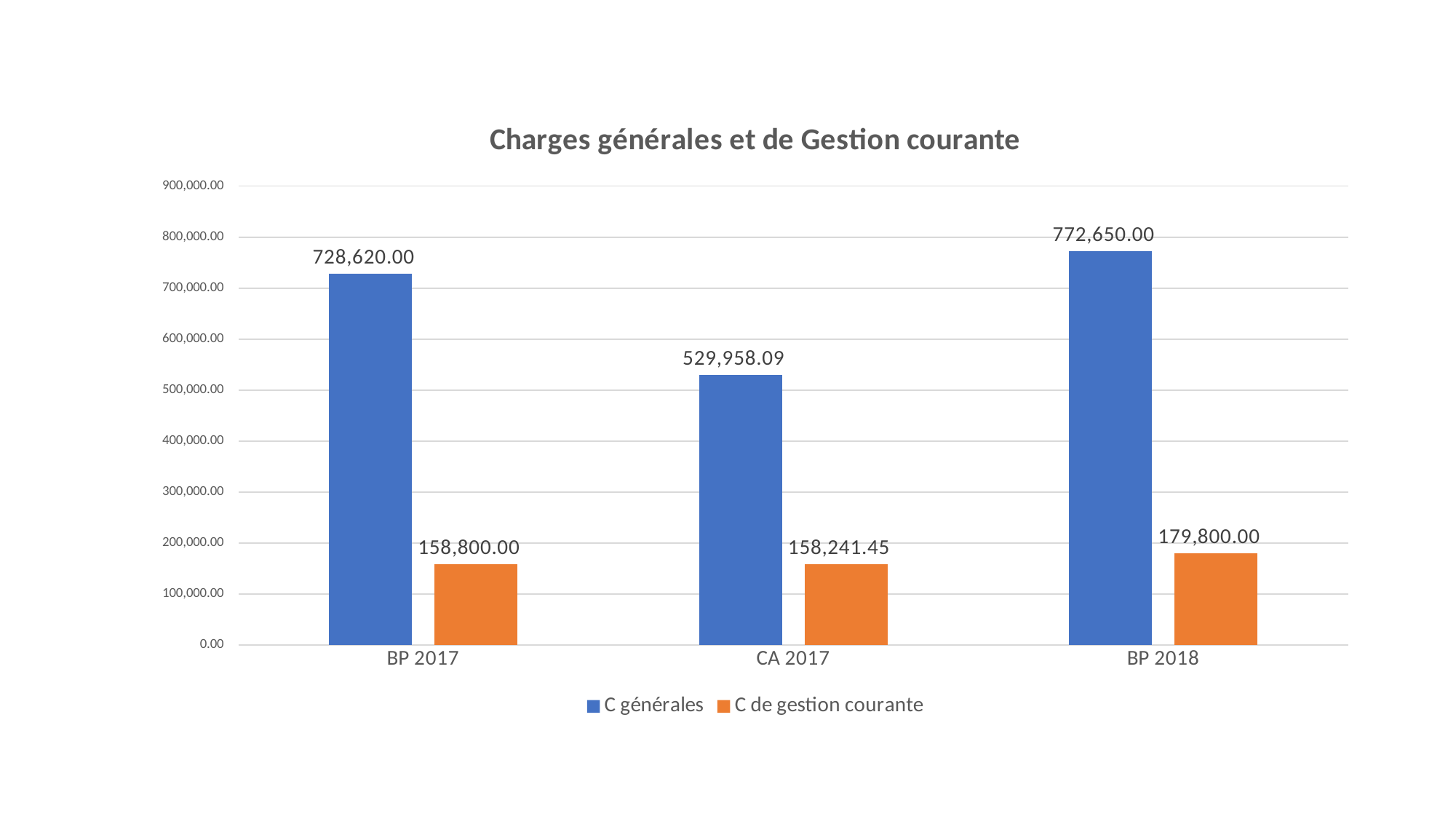
Which category has the lowest value for C générales? CA 2017 How many series does the legend list? 2 What is the value of C de gestion courante for CA 2017? 158,241.45 Is the value of C générales for CA 2017 greater or less than 500,000.00? greater Which category has the highest value for C générales? BP 2018 What is the difference between C générales for BP 2018 and BP 2017? 44,030.00 How many categories are shown on the x axis? 3 Which is larger for CA 2017: C générales or C de gestion courante? C générales Which category has the highest value for C de gestion courante? BP 2018 What is the difference between C de gestion courante for BP 2018 and CA 2017? 21,558.55 What is the value of C générales for BP 2017? 728,620.00 What is the value of C générales for BP 2018? 772,650.00